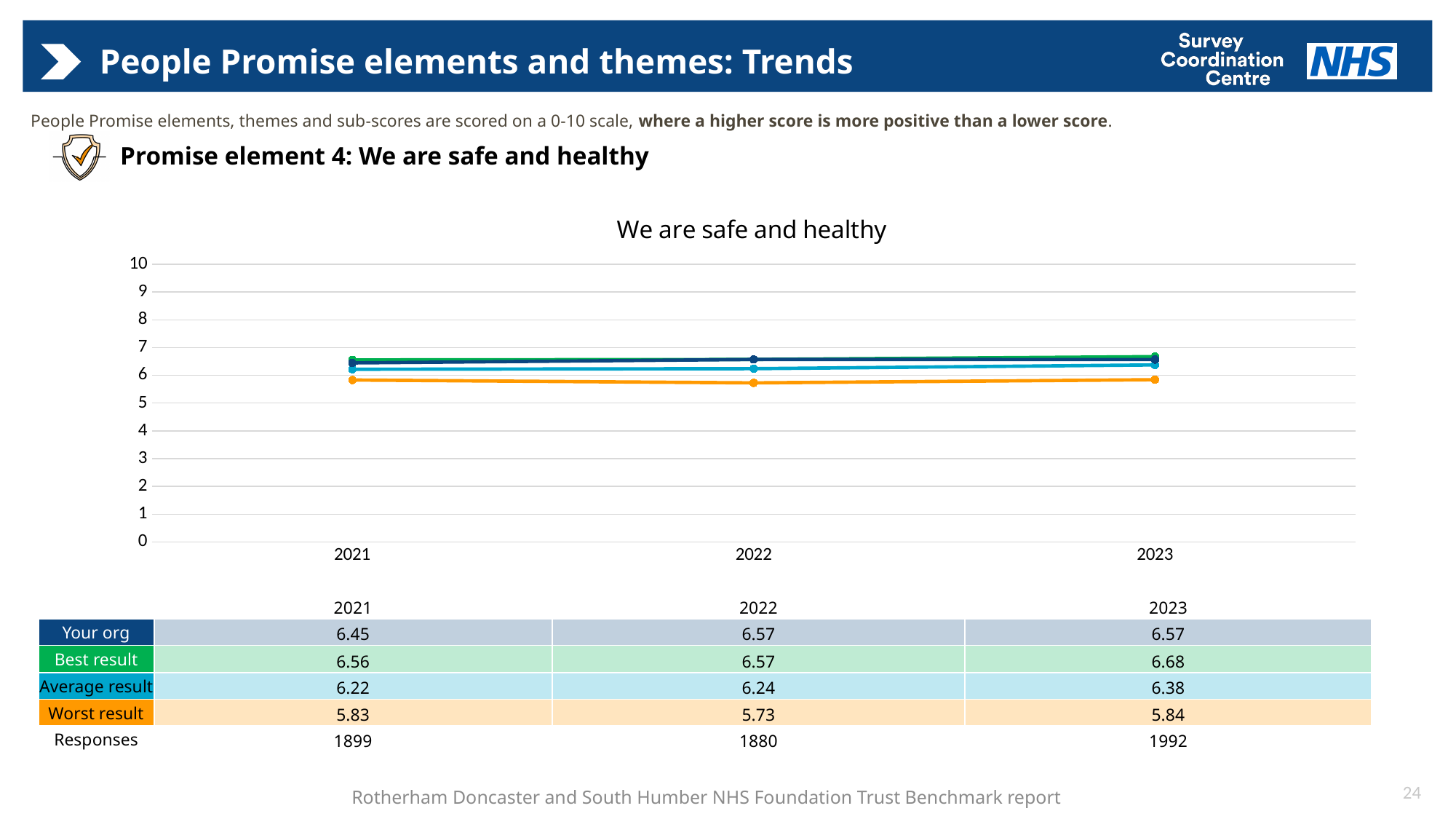
Does the Average result score rise or fall from 2021 to 2023? rise What is the Your org score for 2021? 6.45 What is the title of the chart? We are safe and healthy How many years are plotted on the x axis of the chart? 3 What is the difference between the Best result and Worst result scores in 2023? 0.84 In which year is the Worst result score lowest? 2022 Which is larger in 2021, the Your org score or the Average result score? Your org What is the Best result score for 2023? 6.68 How many series are shown in the chart's table legend? 4 What is the Worst result score for 2022? 5.73 What is the Average result score for 2023? 6.38 What kind of chart is shown on the slide? line chart